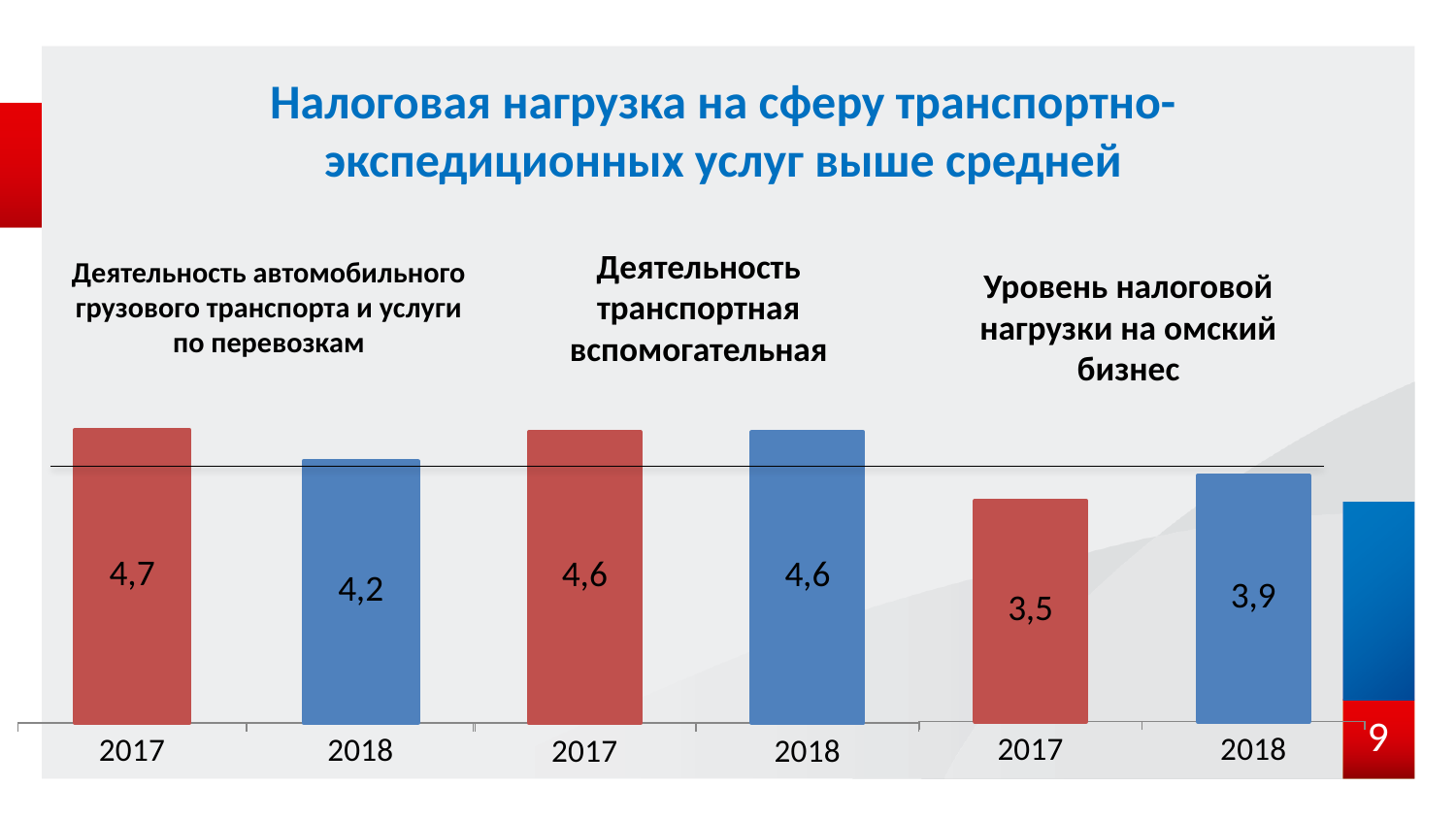
How many bars are plotted on the slide in total? 6 What is the value for 2018 in the group "Уровень налоговой нагрузки на омский бизнес"? 3,9 What is the value for 2017 in the group "Уровень налоговой нагрузки на омский бизнес"? 3,5 What is the value for 2018 in the group "Деятельность транспортная вспомогательная"? 4,6 What is the value for 2018 in the group "Деятельность автомобильного грузового транспорта и услуги по перевозкам"? 4,2 What is the difference between the 2017 and 2018 values in the group "Деятельность автомобильного грузового транспорта и услуги по перевозкам"? 0,5 What type of chart is shown on the slide? Bar chart Which bar on the slide has the lowest value? 2017, Уровень налоговой нагрузки на омский бизнес (3,5) Which bar on the slide has the highest value? 2017, Деятельность автомобильного грузового транспорта и услуги по перевозкам (4,7) What is the difference between the 2018 and 2017 values in the group "Уровень налоговой нагрузки на омский бизнес"? 0,4 Which is larger: the 2018 value for "Деятельность транспортная вспомогательная" or the 2018 value for "Уровень налоговой нагрузки на омский бизнес"? Деятельность транспортная вспомогательная (4,6) What is the value for 2017 in the group "Деятельность автомобильного грузового транспорта и услуги по перевозкам"? 4,7